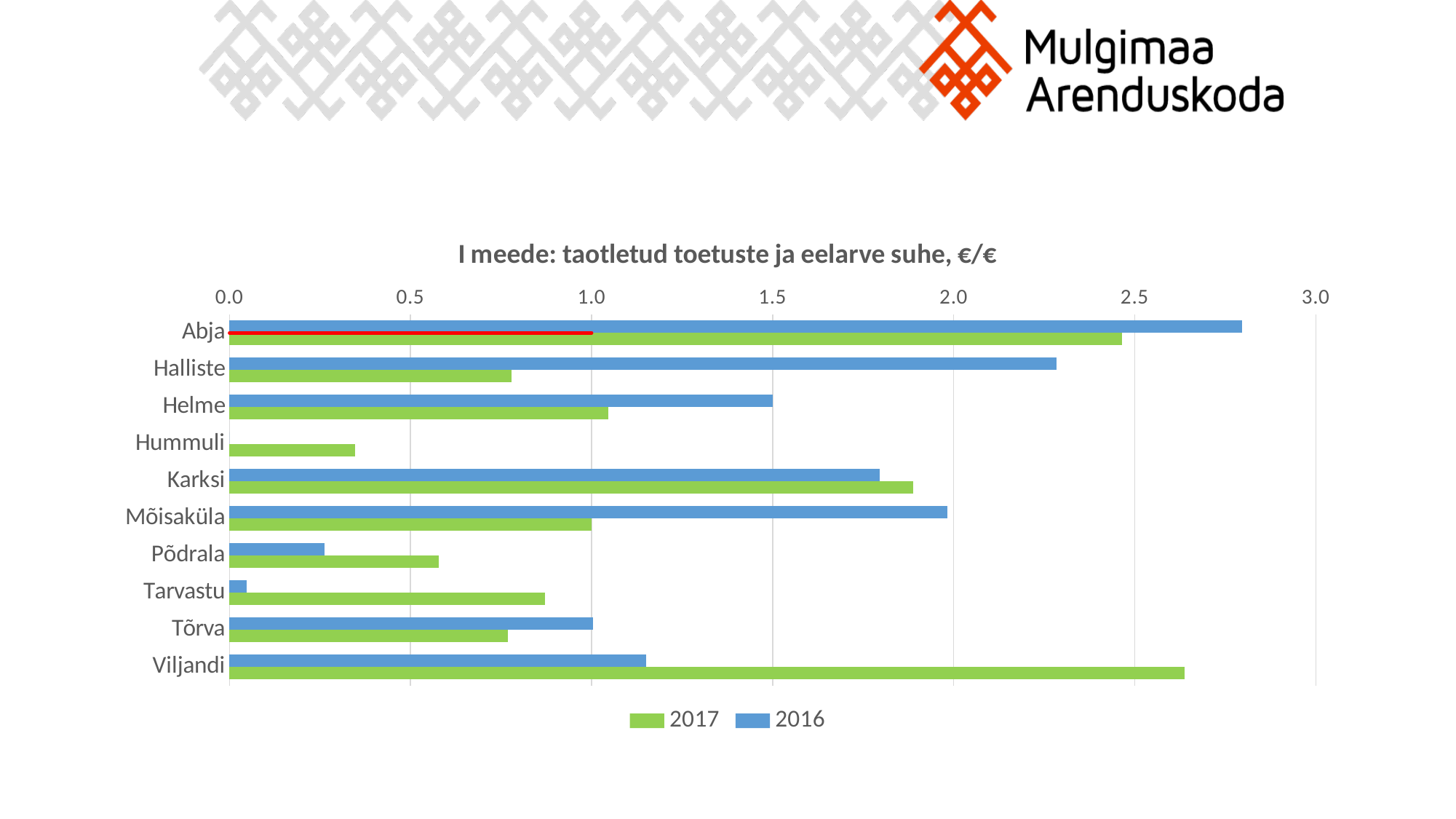
How many categories are shown on the vertical axis of the chart? 10 What kind of chart is shown on the slide? bar chart Which category has the highest value for the 2017 series? Viljandi For Viljandi, which series has the larger value, 2016 or 2017? 2017 Is the 2017 value for Halliste greater or less than 1.0? less Which category has the highest value for the 2016 series? Abja Which category has the lowest value for the 2017 series? Hummuli Is the 2016 value for Abja greater or less than 2.5? greater How many series does the legend list? 2 For Halliste, which series has the larger value, 2016 or 2017? 2016 Is the 2016 value for Põdrala greater or less than 0.5? less What is the title of the chart? I meede: taotletud toetuste ja eelarve suhe, €/€